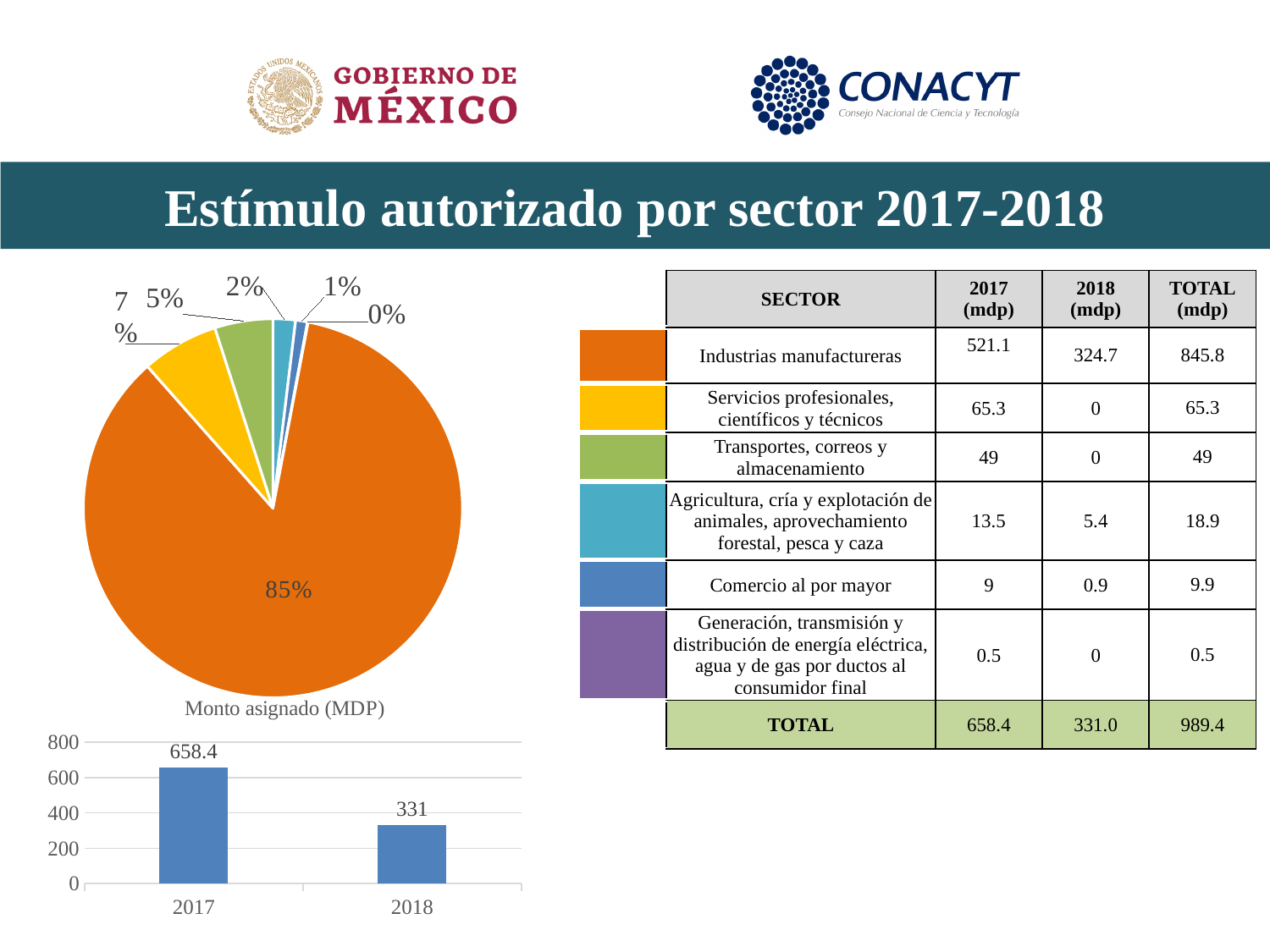
What kind of chart is the one at the top left of the slide? pie chart In the pie chart, what share does the yellow slice have? 7% In the bar chart titled "Monto asignado (MDP)", what is the value for 2018? 331 What kind of chart is the one at the bottom left of the slide, titled "Monto asignado (MDP)"? bar chart In the bar chart titled "Monto asignado (MDP)", what is the difference between the 2017 and 2018 values? 327.4 In the bar chart titled "Monto asignado (MDP)", what is the value for 2017? 658.4 In the bar chart titled "Monto asignado (MDP)", is the value for 2018 greater or less than 400? less In the pie chart, how many slices are labelled with a percentage? 6 In the pie chart, what share does the largest slice (orange) have? 85% In the bar chart titled "Monto asignado (MDP)", how many bars are plotted? 2 In the bar chart titled "Monto asignado (MDP)", which year has the higher value? 2017 In the bar chart titled "Monto asignado (MDP)", do the values rise or fall from 2017 to 2018? fall